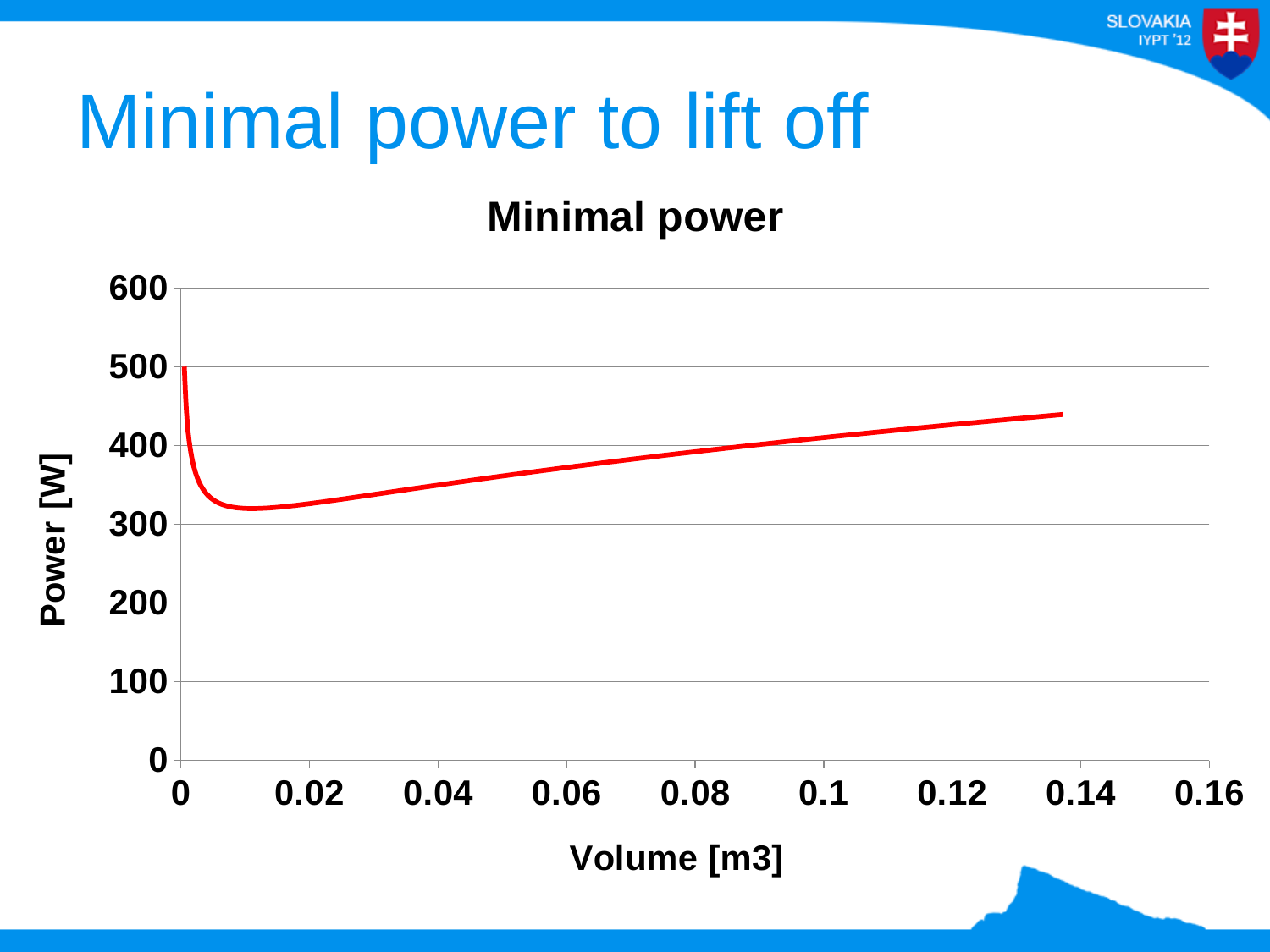
Which is larger: the value at the left end of the curve or the value at the right end of the curve? left end Is the value of the curve at its left end (volume near 0) greater or less than 400? greater Is the lowest value reached by the curve greater or less than 300? greater Is the value of the curve at a volume of 0.12 greater or less than 400? greater Which is larger: the value of the curve at a volume of 0.02 or at a volume of 0.12? 0.12 What kind of chart is shown on the slide? line chart Does the curve rise or fall as volume increases from 0.02 to 0.12? rises What is the title of the chart? Minimal power What is the label of the vertical axis of the chart? Power [W]